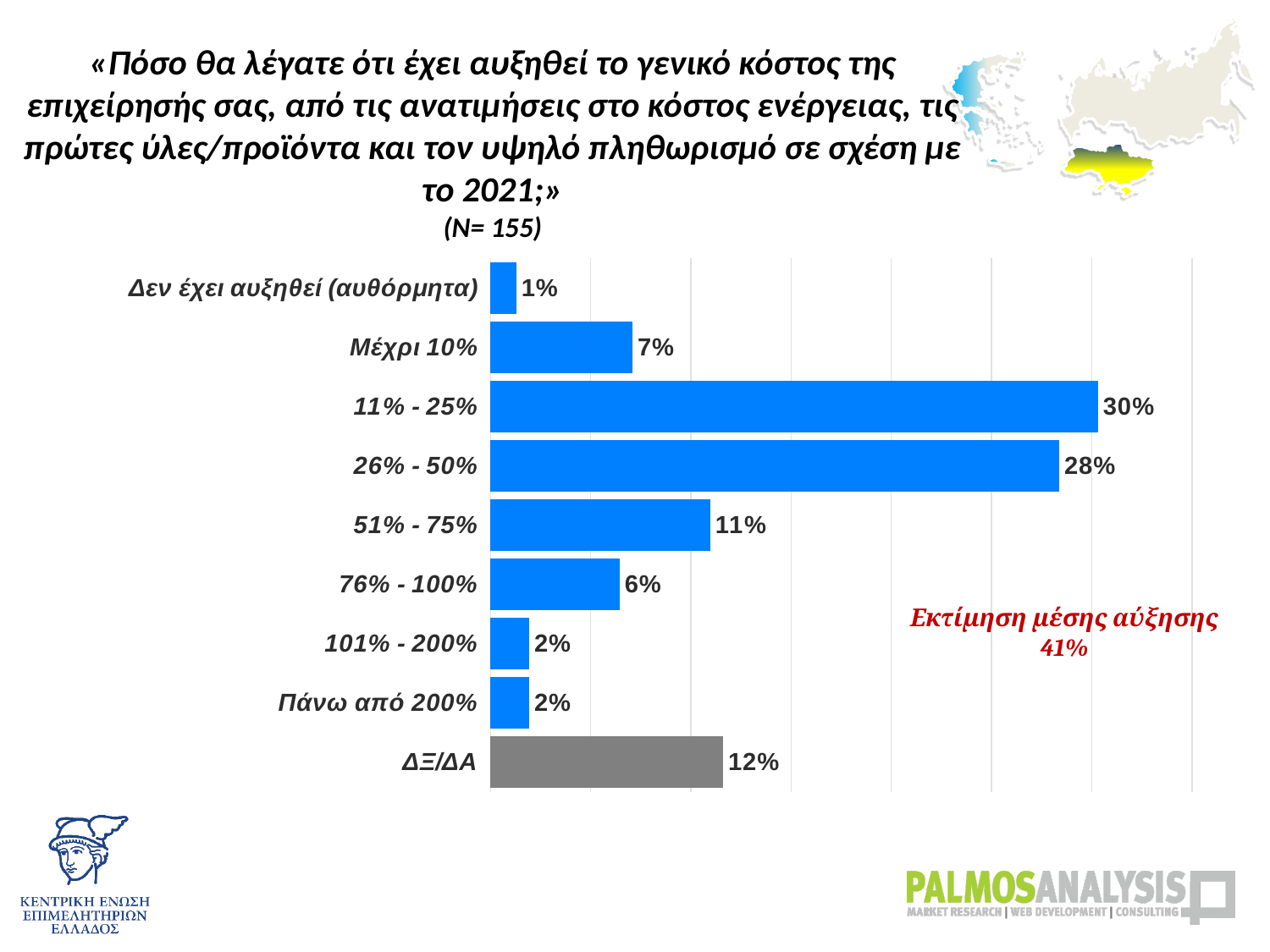
Which category has the highest value? 11% - 25% What is the difference between the values for "11% - 25%" and "26% - 50%"? 2% What is the value shown for "ΔΞ/ΔΑ"? 12% What percentage of respondents answered "11% - 25%"? 30% How many categories are shown in the chart? 9 What kind of chart is shown on the slide? Bar chart Which is larger, the value for "51% - 75%" or the value for "76% - 100%"? 51% - 75% What percentage of respondents answered "Μέχρι 10%"? 7% What is the combined value of "101% - 200%" and "Πάνω από 200%"? 4% What is the sample size (N) shown on the slide? 155 What is the estimated average increase (Εκτίμηση μέσης αύξησης) shown on the slide? 41% Which category has the lowest value? Δεν έχει αυξηθεί (αυθόρμητα)